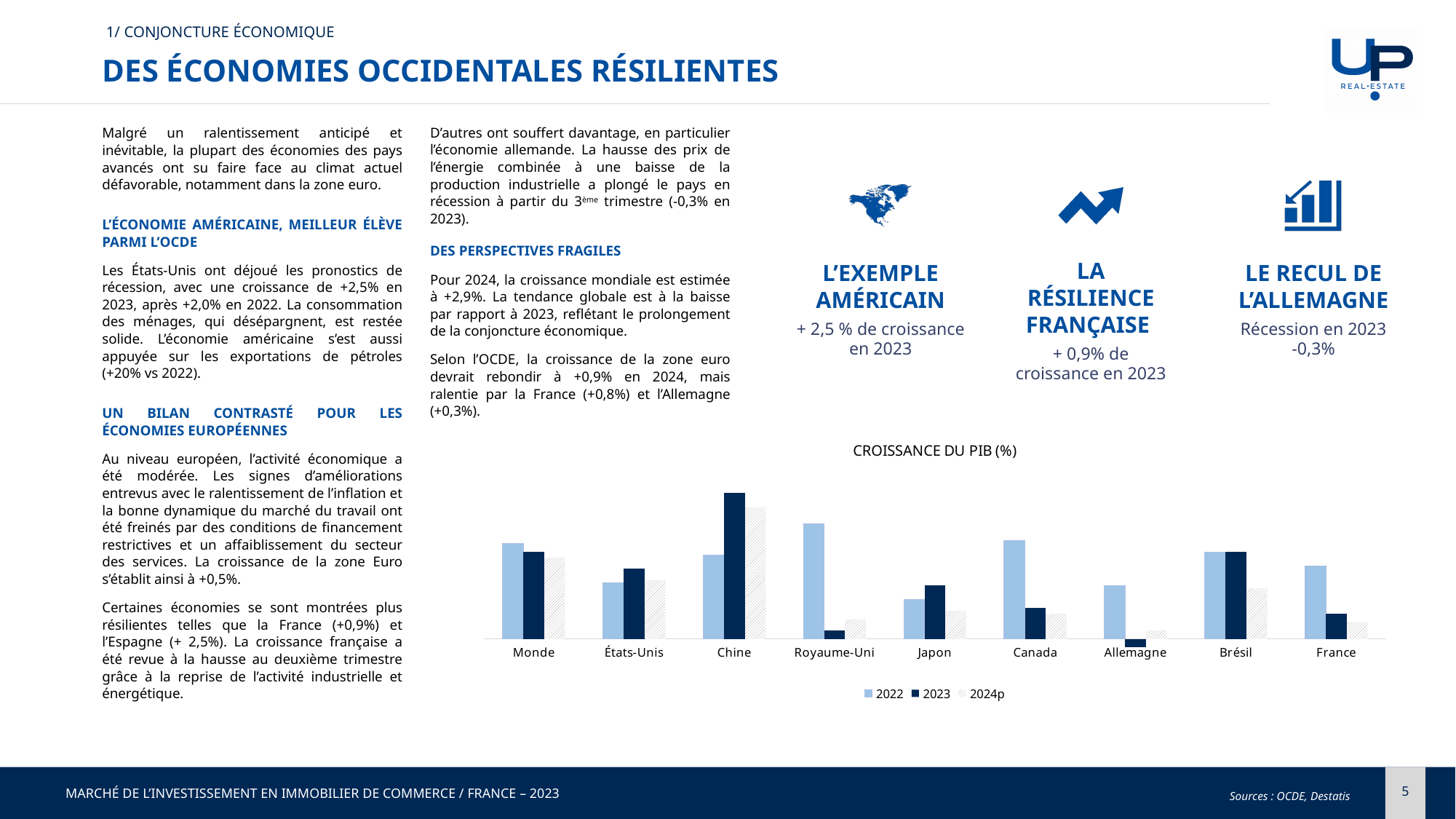
Which category has the highest value for the 2023 series? Chine Which category has the lowest value for the 2023 series? Allemagne How many categories (countries/regions) are shown on the x axis of the chart? 9 How many series does the chart legend list? 3 Which category has the highest value for the 2022 series? Royaume-Uni What kind of chart is shown on the slide? bar chart Which is larger for 2023: the value for Japon or the value for Allemagne? Japon For France, does the value rise or fall from 2022 to 2023? fall What are the series listed in the chart legend? 2022, 2023, 2024p Which is larger for 2023: the value for Chine or the value for États-Unis? Chine What is the title of the chart? CROISSANCE DU PIB (%) For Royaume-Uni, is the 2022 value larger or smaller than the 2023 value? larger